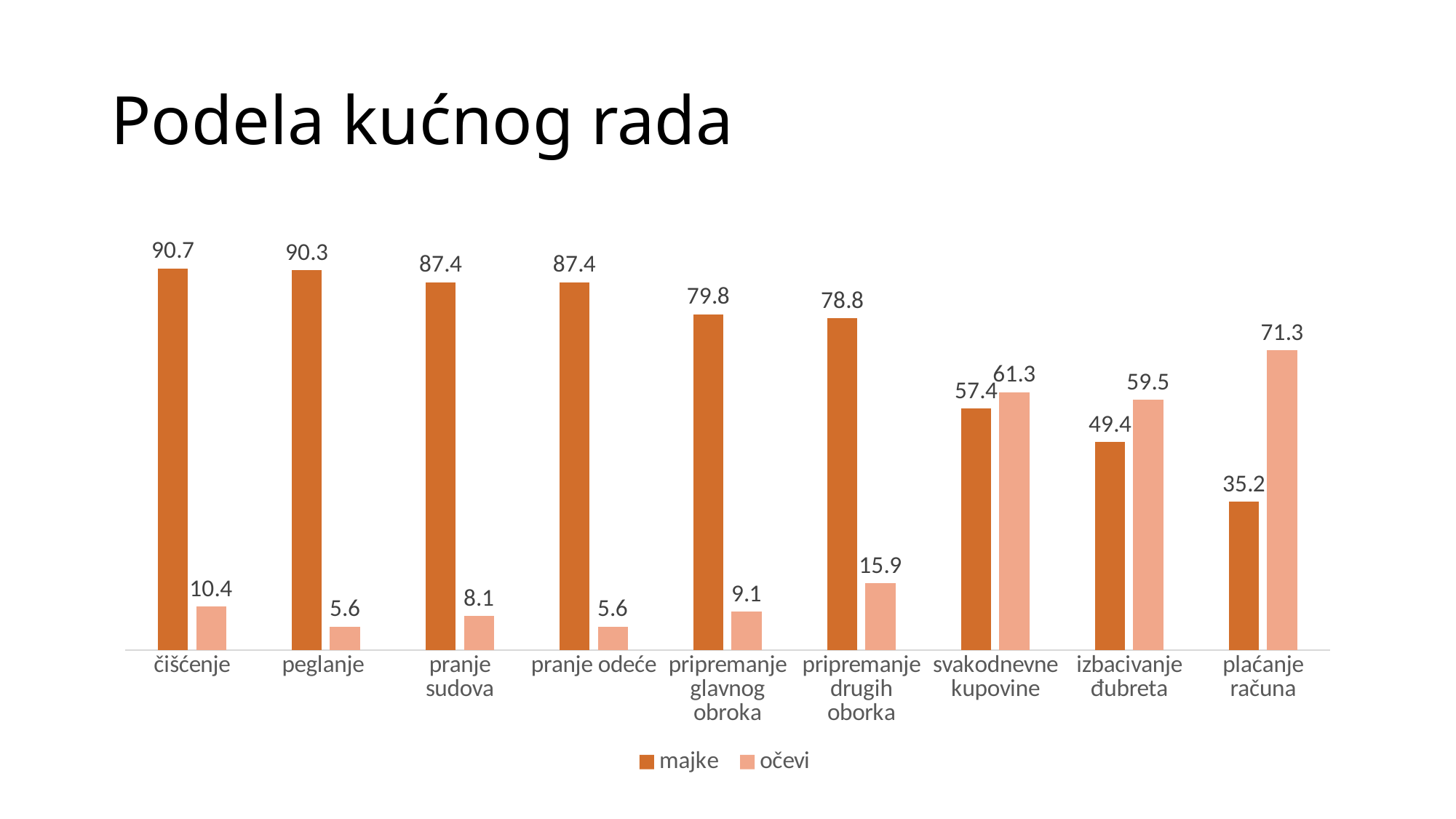
What kind of chart is shown on the slide? bar chart Which category has the highest value for majke? čišćenje Which is larger for svakodnevne kupovine, the majke value or the očevi value? očevi What is the title of the slide? Podela kućnog rada Which category has the lowest value for majke? plaćanje računa What is the value for majke for čišćenje? 90.7 What is the value for očevi for plaćanje računa? 71.3 How many categories are shown on the x axis? 9 How many series does the legend list? 2 What is the difference between the majke and očevi values for čišćenje? 80.3 Which category has the highest value for očevi? plaćanje računa What is the value for očevi for pripremanje drugih oborka? 15.9